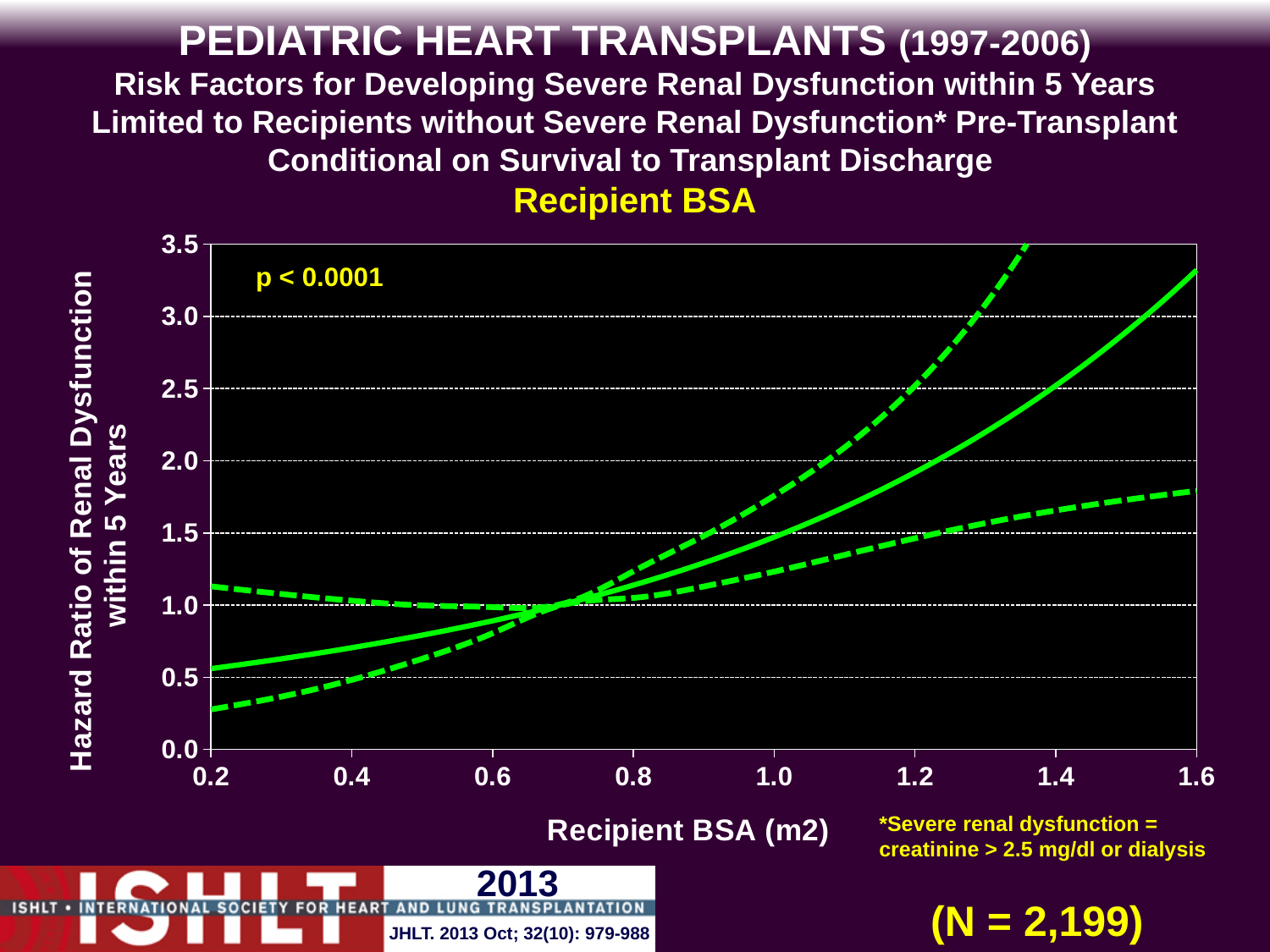
Does the solid hazard ratio line rise or fall as Recipient BSA increases from 0.2 to 1.6? rises What is the label of the x axis? Recipient BSA (m2) Is the hazard ratio on the solid line at a Recipient BSA of 0.8 greater or less than 1.0? greater What kind of chart is shown on the slide? line chart Is the hazard ratio on the solid line at a Recipient BSA of 1.6 greater or less than 3.0? greater Is the hazard ratio on the solid line at a Recipient BSA of 0.2 greater or less than 1.0? less What p-value is printed on the chart? p < 0.0001 How many lines are plotted on the chart? 3